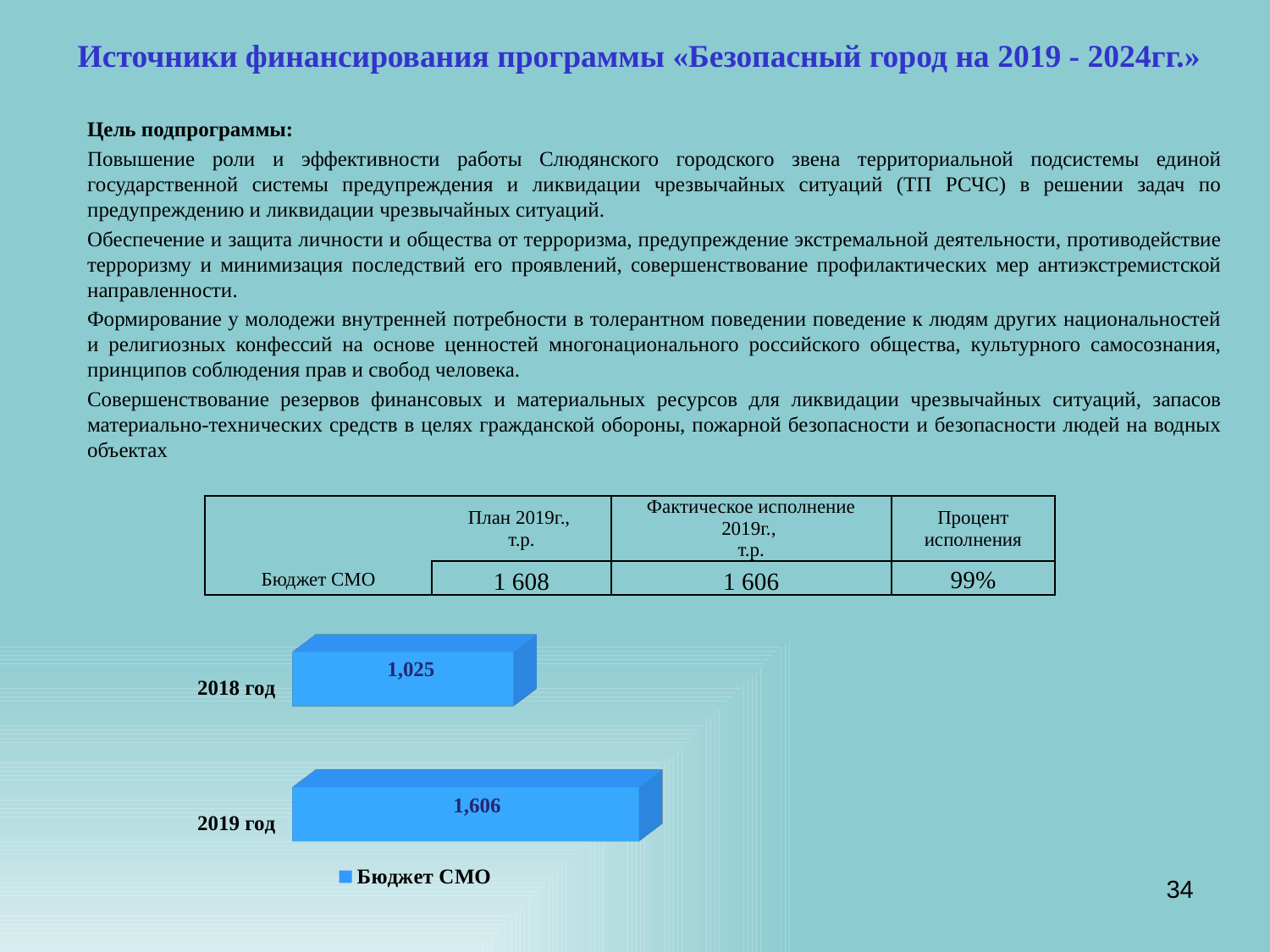
What is the value for 2019 год in the bar chart? 1,606 Does the value rise or fall from 2018 год to 2019 год in the bar chart? rise Which year has the lower value in the bar chart? 2018 год What kind of chart is shown on the slide? bar chart Is the value for 2018 год larger or smaller than the value for 2019 год in the bar chart? smaller What is the difference between the values for 2019 год and 2018 год in the bar chart? 581 How many series does the legend of the bar chart list? 1 Which year has the higher value in the bar chart? 2019 год What is the value for 2018 год in the bar chart? 1,025 How many categories (years) are shown in the bar chart? 2 What colour are the bars in the chart? blue What is the name of the series shown in the legend of the bar chart? Бюджет СМО